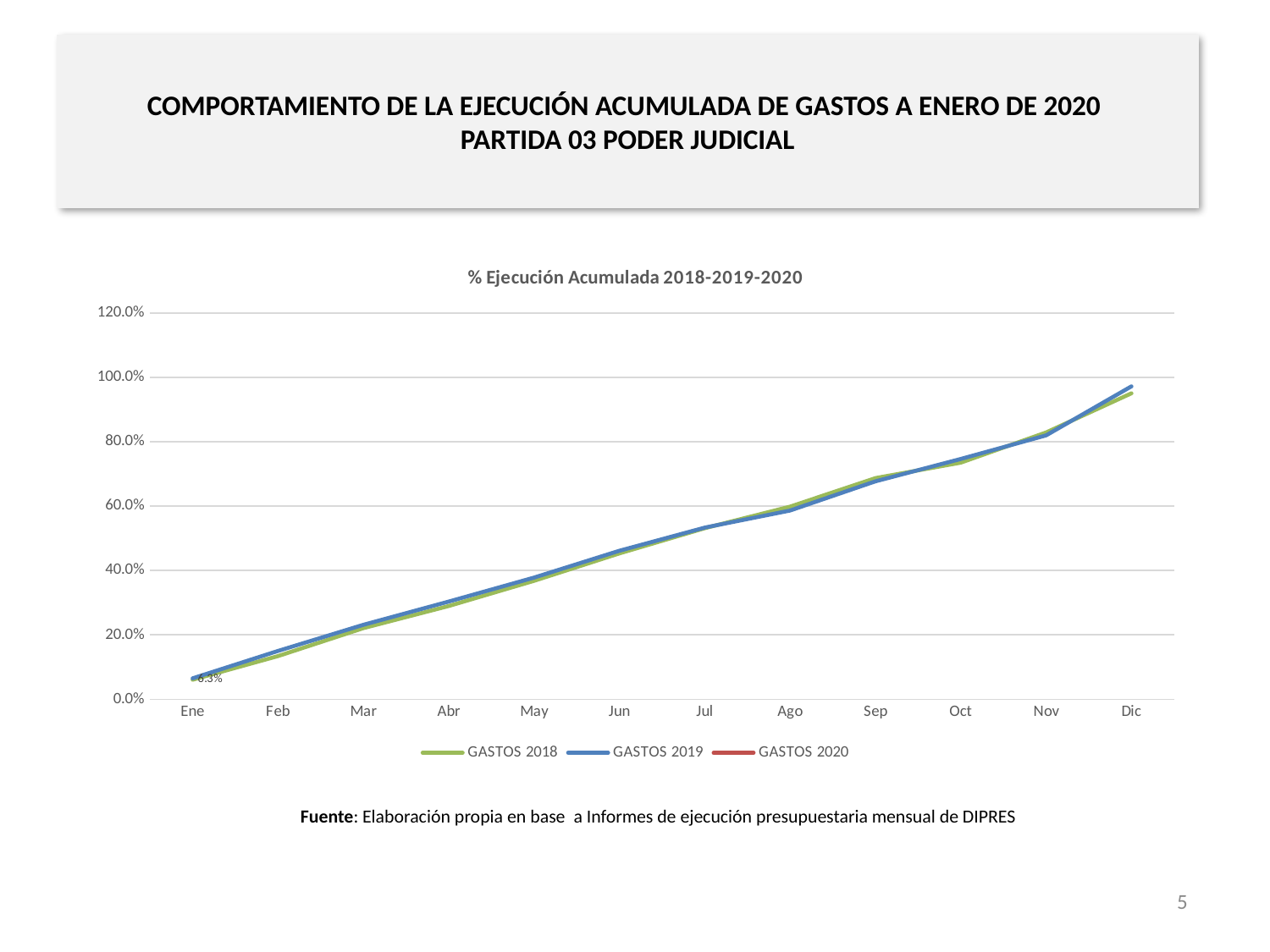
Is the value for GASTOS 2019 in Dic greater or less than 80.0%? greater In which month does GASTOS 2019 reach its highest value? Dic What kind of chart is shown on the slide? line chart Is the value for GASTOS 2018 in Abr greater or less than 40.0%? less How many series does the legend list? 3 Do the values for GASTOS 2019 rise or fall from Ene to Dic? rise Is the value for GASTOS 2019 in Oct greater or less than 60.0%? greater What is the title of the chart? % Ejecución Acumulada 2018-2019-2020 What value is printed as a data label at Ene? 6.3% In which month is GASTOS 2018 at its lowest value? Ene How many months are shown along the x axis? 12